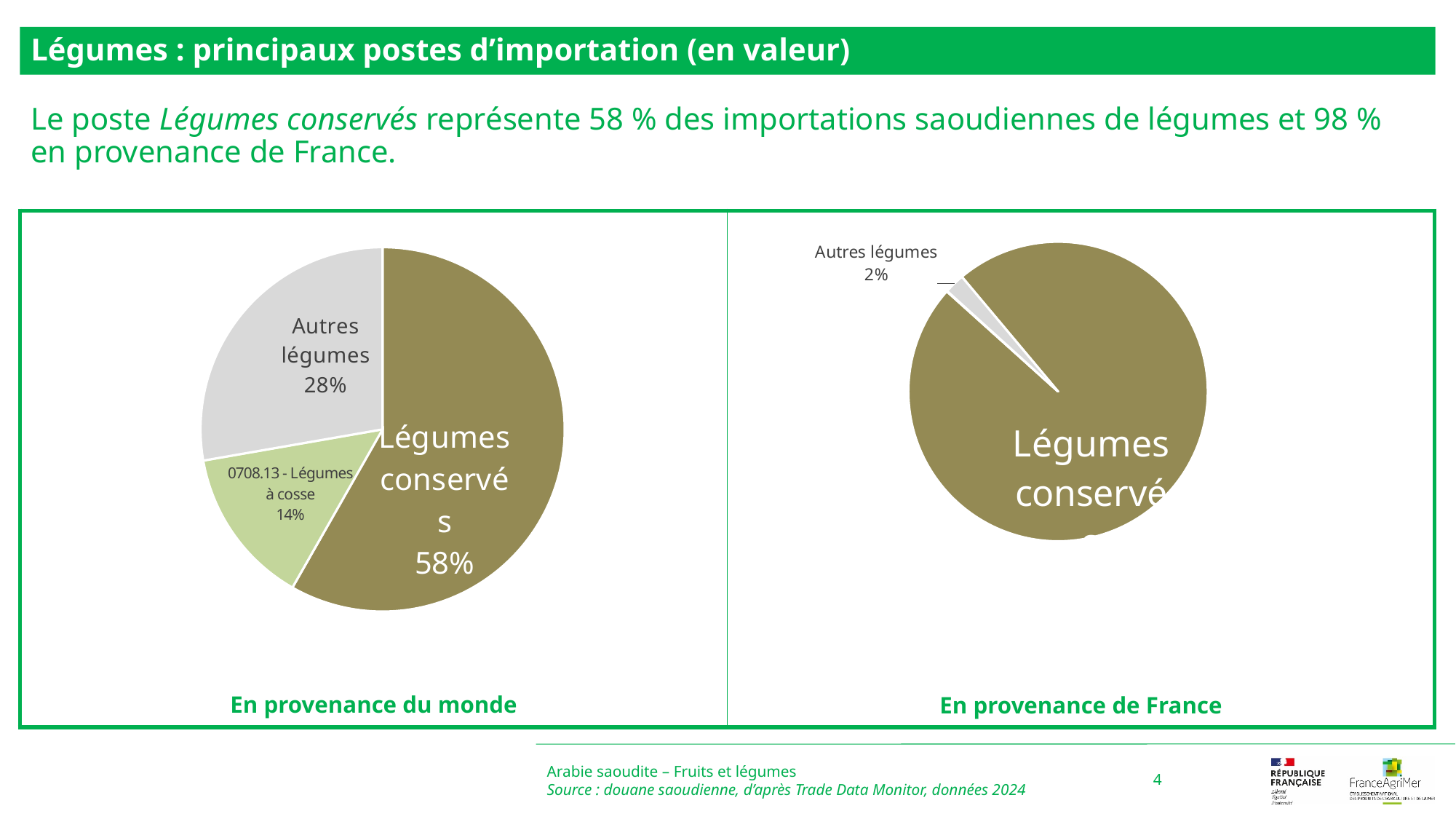
In the 'En provenance de France' chart, which category has the largest share? Légumes conservés In the 'En provenance de France' chart, what share do Autres légumes represent? 2% In the 'En provenance du monde' chart, what share do Légumes conservés represent? 58% What type of chart is used in the 'En provenance de France' panel? Pie chart In the 'En provenance du monde' chart, which category has the largest share? Légumes conservés In the 'En provenance du monde' chart, which category has the smallest share? 0708.13 - Légumes à cosse In the 'En provenance du monde' chart, what share does 0708.13 - Légumes à cosse represent? 14% In the 'En provenance du monde' chart, which is larger: Autres légumes or 0708.13 - Légumes à cosse? Autres légumes In the 'En provenance du monde' chart, what share do Autres légumes represent? 28% How many slices does the 'En provenance du monde' pie chart have? 3 In the 'En provenance du monde' chart, what is the difference in percentage points between Légumes conservés and Autres légumes? 30 percentage points How many slices does the 'En provenance de France' pie chart have? 2